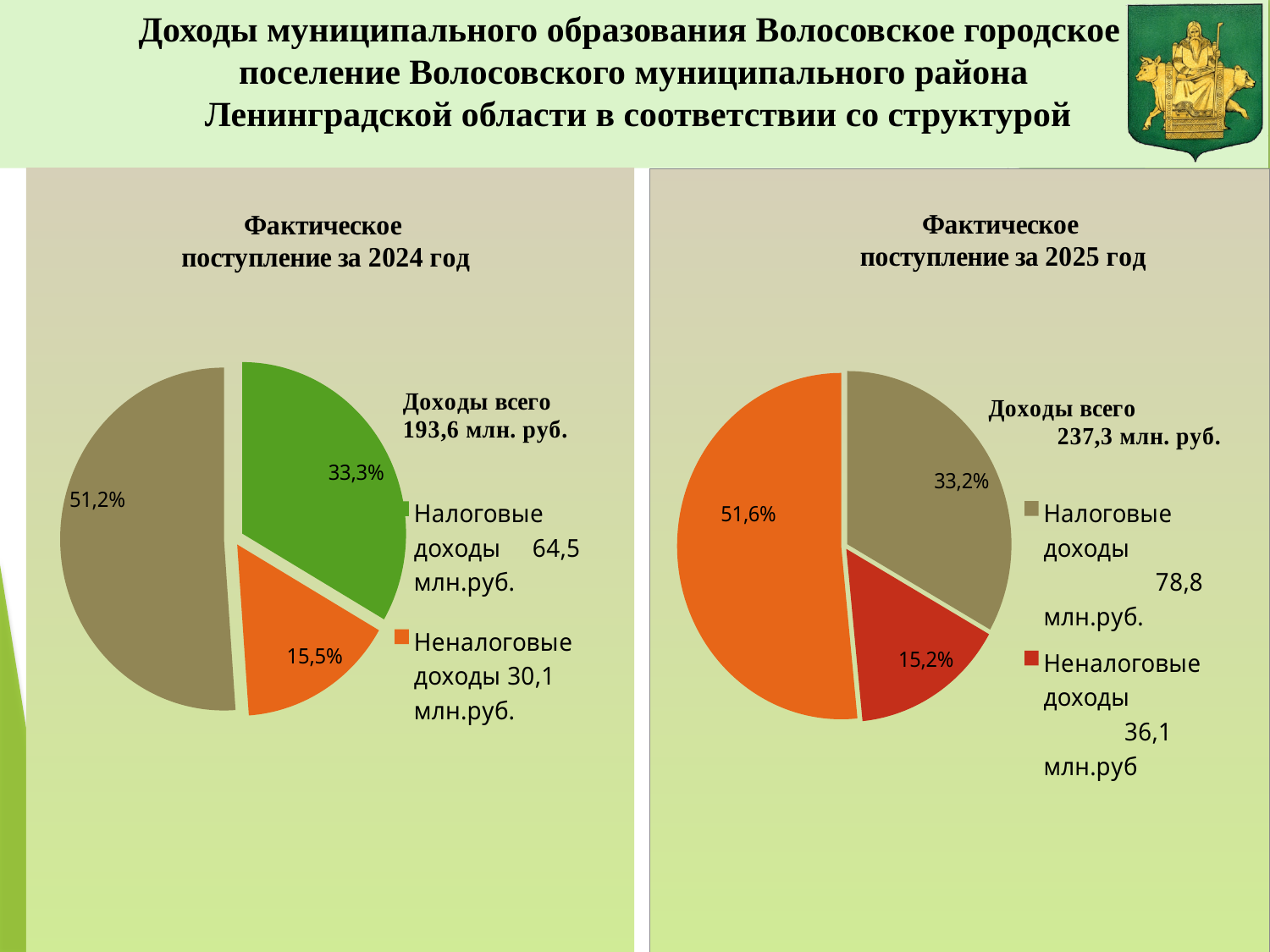
In the chart "Фактическое поступление за 2024 год", what amount in млн.руб. is given for Налоговые доходы? 64,5 млн.руб. In the chart "Фактическое поступление за 2025 год", what total income (Доходы всего) is stated? 237,3 млн. руб. In the chart "Фактическое поступление за 2025 год", which is larger: Налоговые доходы or Неналоговые доходы? Налоговые доходы In the chart "Фактическое поступление за 2024 год", what is the largest percentage label shown on the pie? 51,2% What kind of chart is shown under the title "Фактическое поступление за 2024 год"? Pie chart In the chart "Фактическое поступление за 2024 год", what total income (Доходы всего) is stated? 193,6 млн. руб. How many slices does the pie in the chart "Фактическое поступление за 2025 год" have? 3 In the chart "Фактическое поступление за 2025 год", what amount in млн.руб. is given for Неналоговые доходы? 36,1 млн.руб In the chart "Фактическое поступление за 2025 год", what share of the pie is labelled for Налоговые доходы? 33,2% In the chart "Фактическое поступление за 2024 год", what share of the pie is labelled for Неналоговые доходы? 15,5% In the chart "Фактическое поступление за 2025 год", what is the difference in percentage points between the 51,6% slice and the 15,2% slice? 36,4 In the chart "Фактическое поступление за 2024 год", what share of the pie is labelled for Налоговые доходы? 33,3%